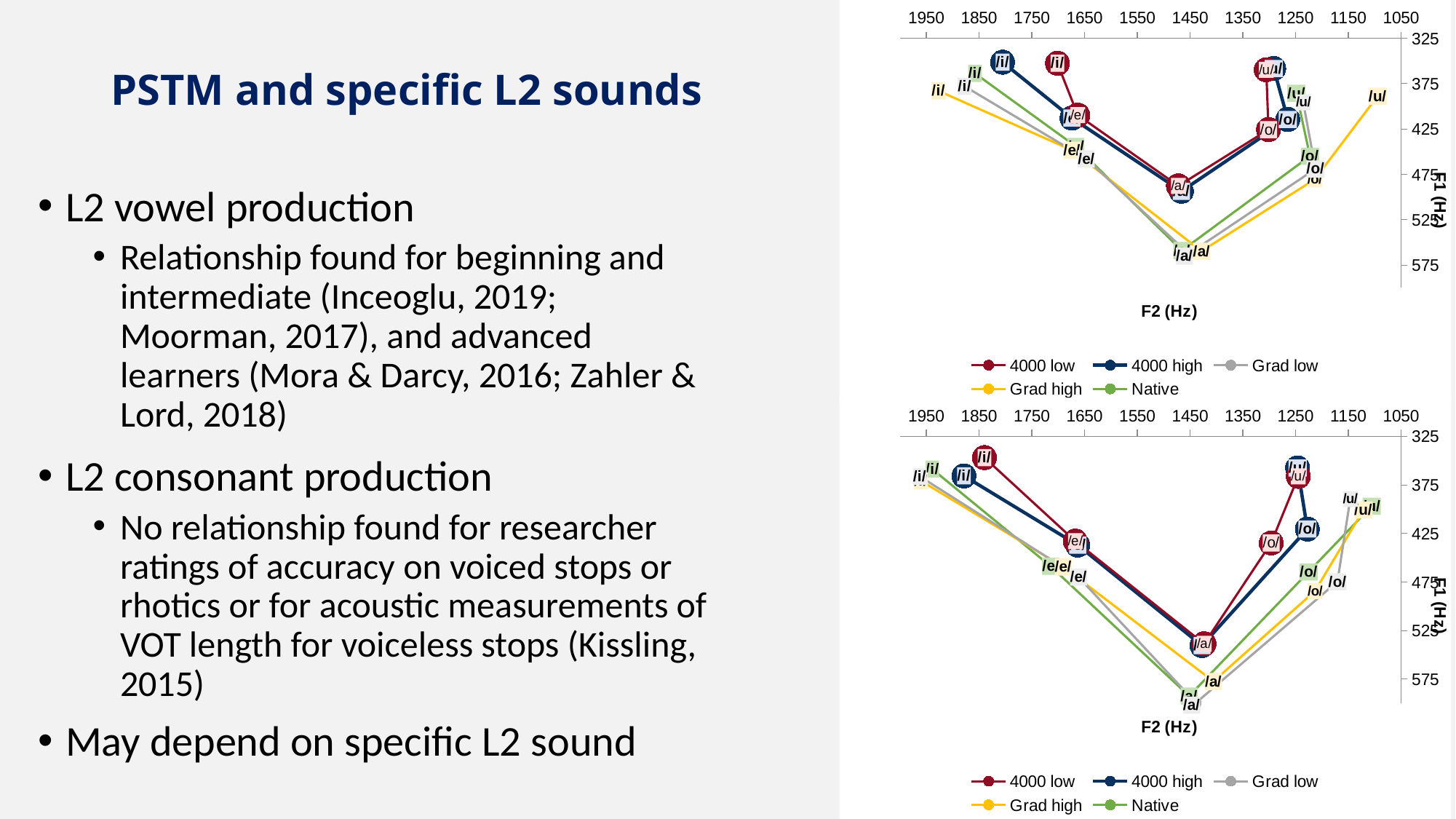
In the top chart, is the F1 value of the 4000 low /i/ point greater or less than 375? less What is the horizontal axis title of the bottom chart? F2 (Hz) In the bottom chart, which series has the higher F2 value for /i/: Grad low or 4000 low? Grad low In the top chart, is the F1 value of the Native /a/ point greater or less than 525? greater In the top chart, which series has the higher F1 value for /a/: Native or 4000 low? Native What is the vertical axis title of the top chart? F1 (Hz) How many series does the legend of the top chart list? 5 What kind of chart is the top chart? line chart In the top chart, is the F2 value of the Grad high /u/ point greater or less than 1150? less How many series does the legend of the bottom chart list? 5